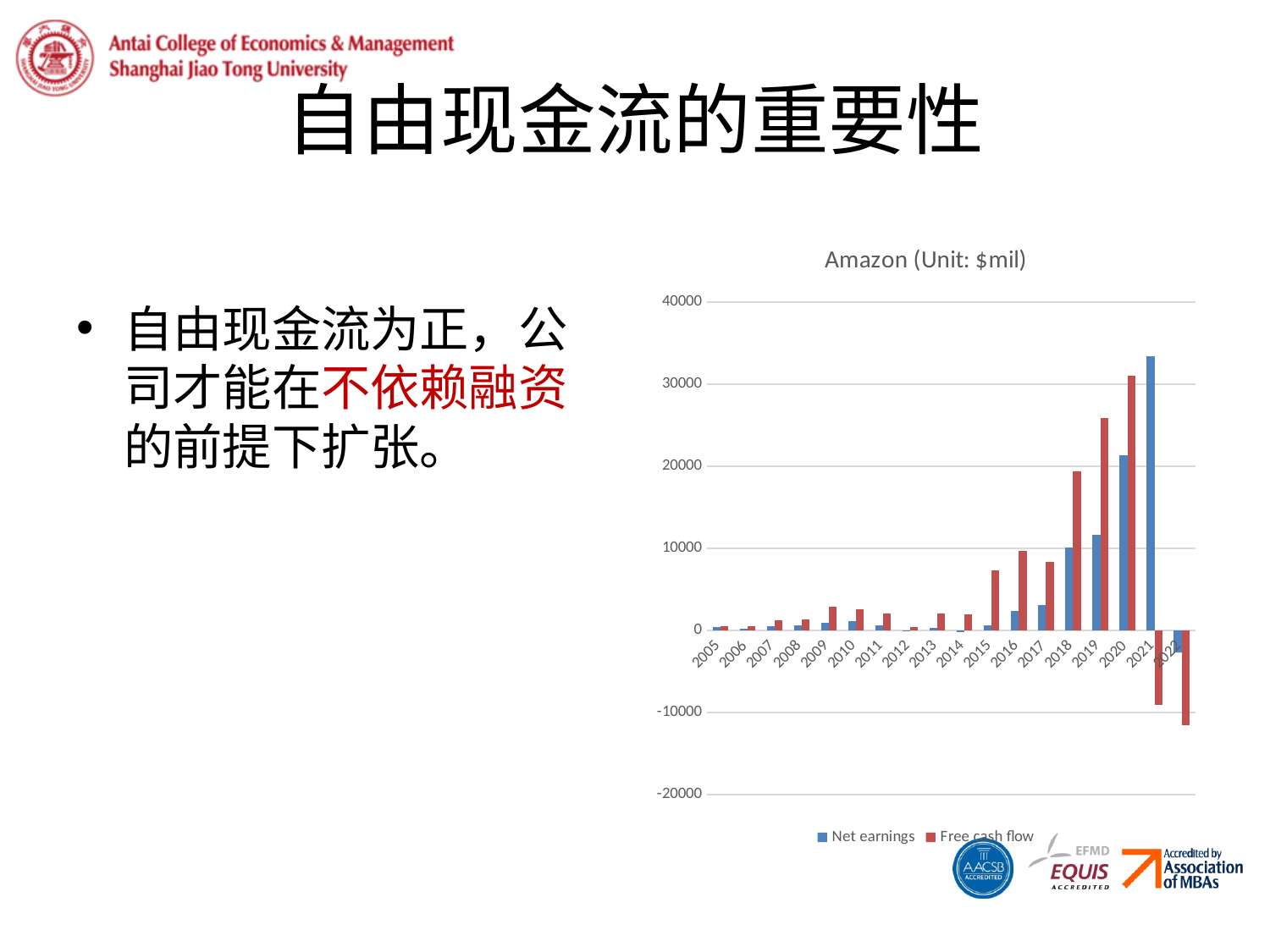
How many series does the chart's legend list? 2 In which year is Net earnings highest? 2021 What is the title of the chart? Amazon (Unit: $mil) Is the Net earnings value for 2021 greater or less than 30000? greater In which year is Free cash flow highest? 2020 What kind of chart is shown on the slide? Bar chart Do Net earnings generally rise or fall from 2015 to 2021? Rise In 2020, which is larger: Net earnings or Free cash flow? Free cash flow Is the Free cash flow value for 2019 greater or less than 20000? greater Is the Free cash flow value for 2022 greater or less than -10000? less How many years are shown on the x axis of the chart? 18 In which year is Free cash flow lowest? 2022